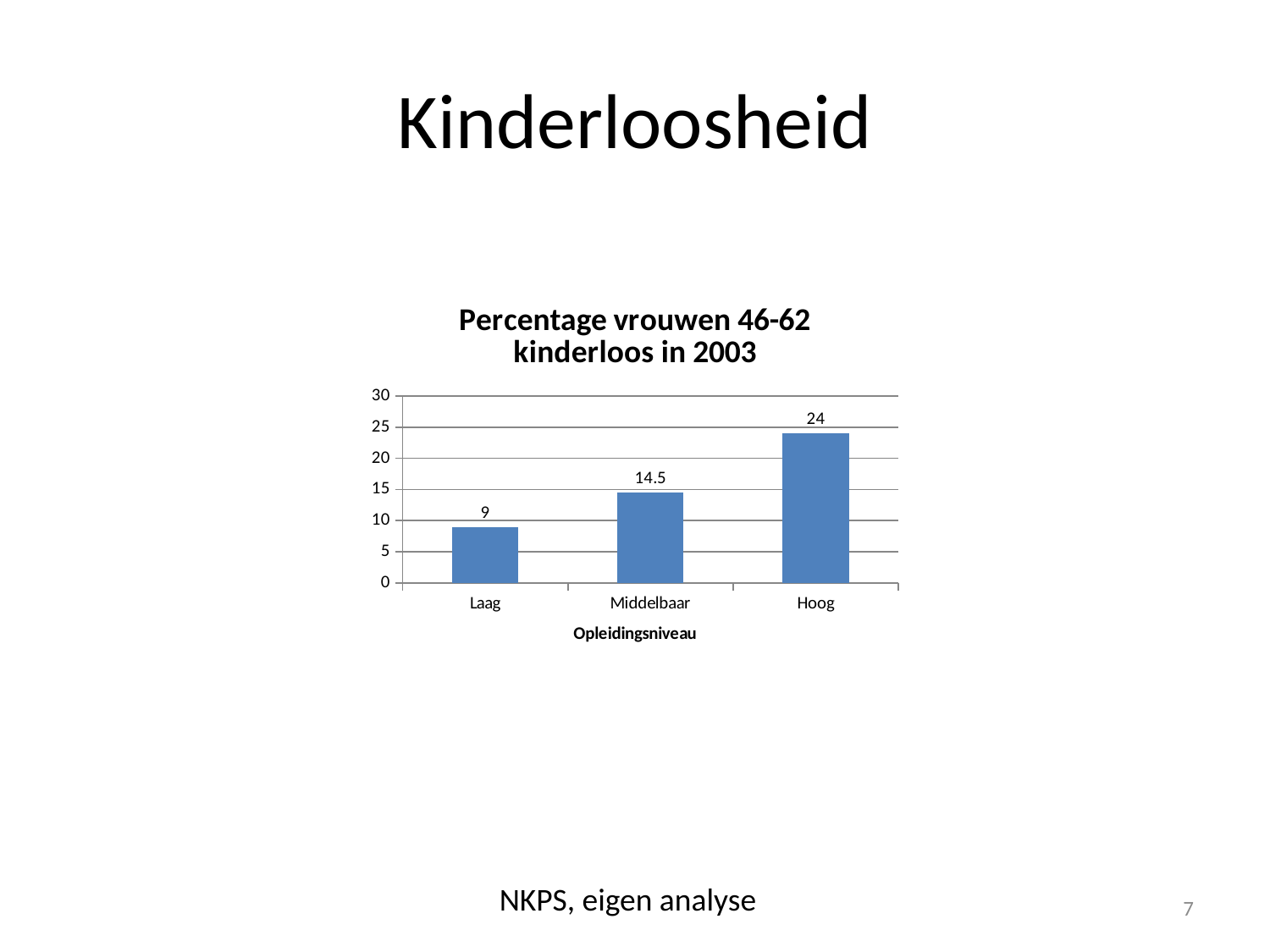
Is the value for Hoog greater or less than 20? greater Do the values rise or fall from Laag to Hoog? rise What kind of chart is shown on the slide? bar chart Which education level has the lowest percentage of childless women? Laag Which education level has the highest percentage of childless women? Hoog What is the value for Hoog? 24 What is the difference between the values for Hoog and Laag? 15 What is the difference between the values for Middelbaar and Laag? 5.5 Which is larger, the value for Middelbaar or the value for Hoog? Hoog What is the value for Middelbaar? 14.5 How many education levels are shown on the x axis? 3 What is the value for Laag? 9